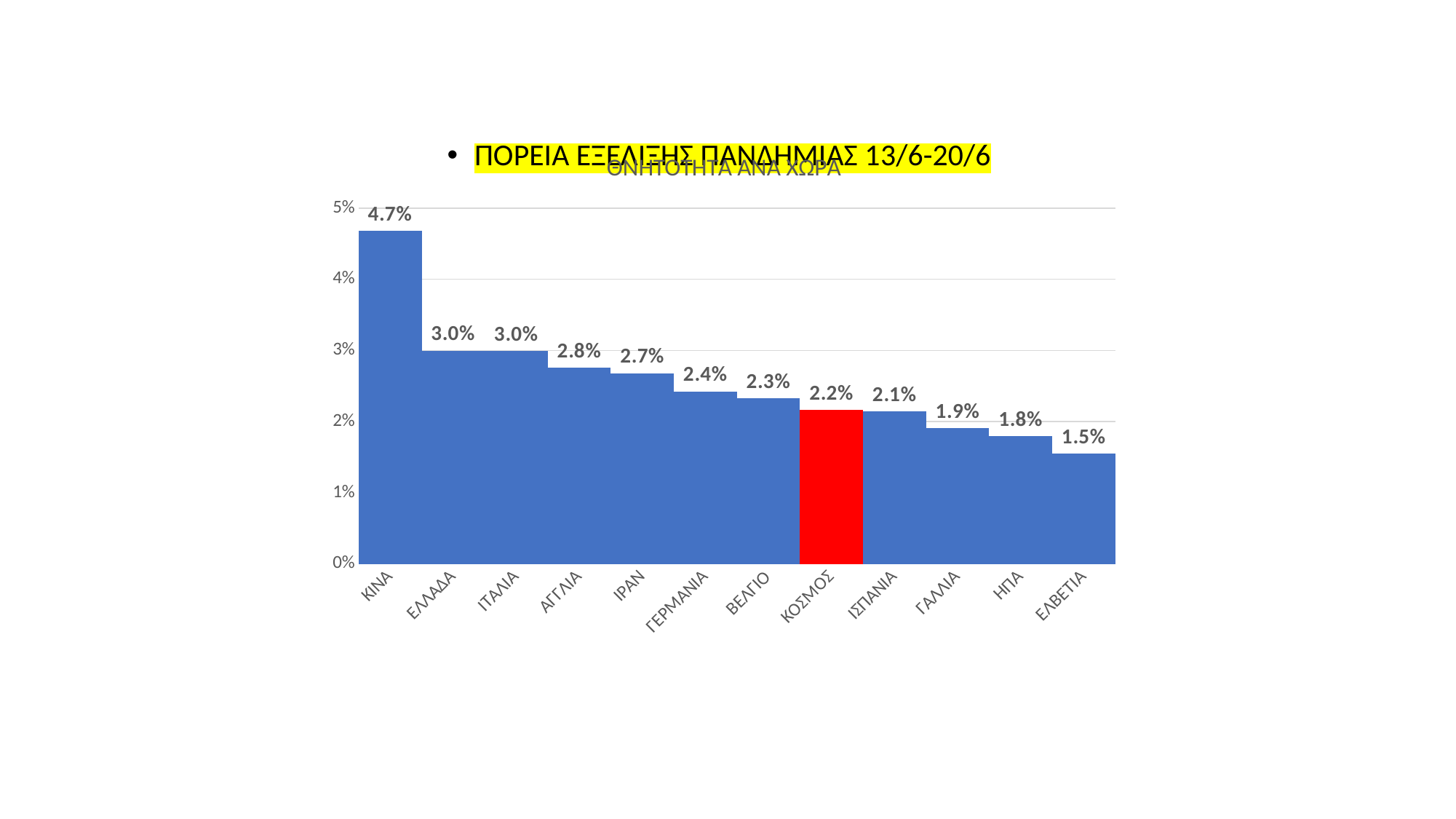
What is the value for ΚΙΝΑ? 4.7% What is the value for ΓΕΡΜΑΝΙΑ? 2.4% What is the value for ΚΟΣΜΟΣ? 2.2% Which category has the highest value? ΚΙΝΑ Which category's bar is coloured red? ΚΟΣΜΟΣ How many categories are shown on the x axis? 12 What is the value for ΕΛΒΕΤΙΑ? 1.5% Which category has the lowest value? ΕΛΒΕΤΙΑ Is the value for ΑΓΓΛΙΑ greater or less than 3%? less What kind of chart is shown on the slide? bar chart Which is larger, the value for ΙΡΑΝ or the value for ΙΣΠΑΝΙΑ? ΙΡΑΝ What is the difference between the values for ΚΙΝΑ and ΕΛΛΑΔΑ? 1.7%